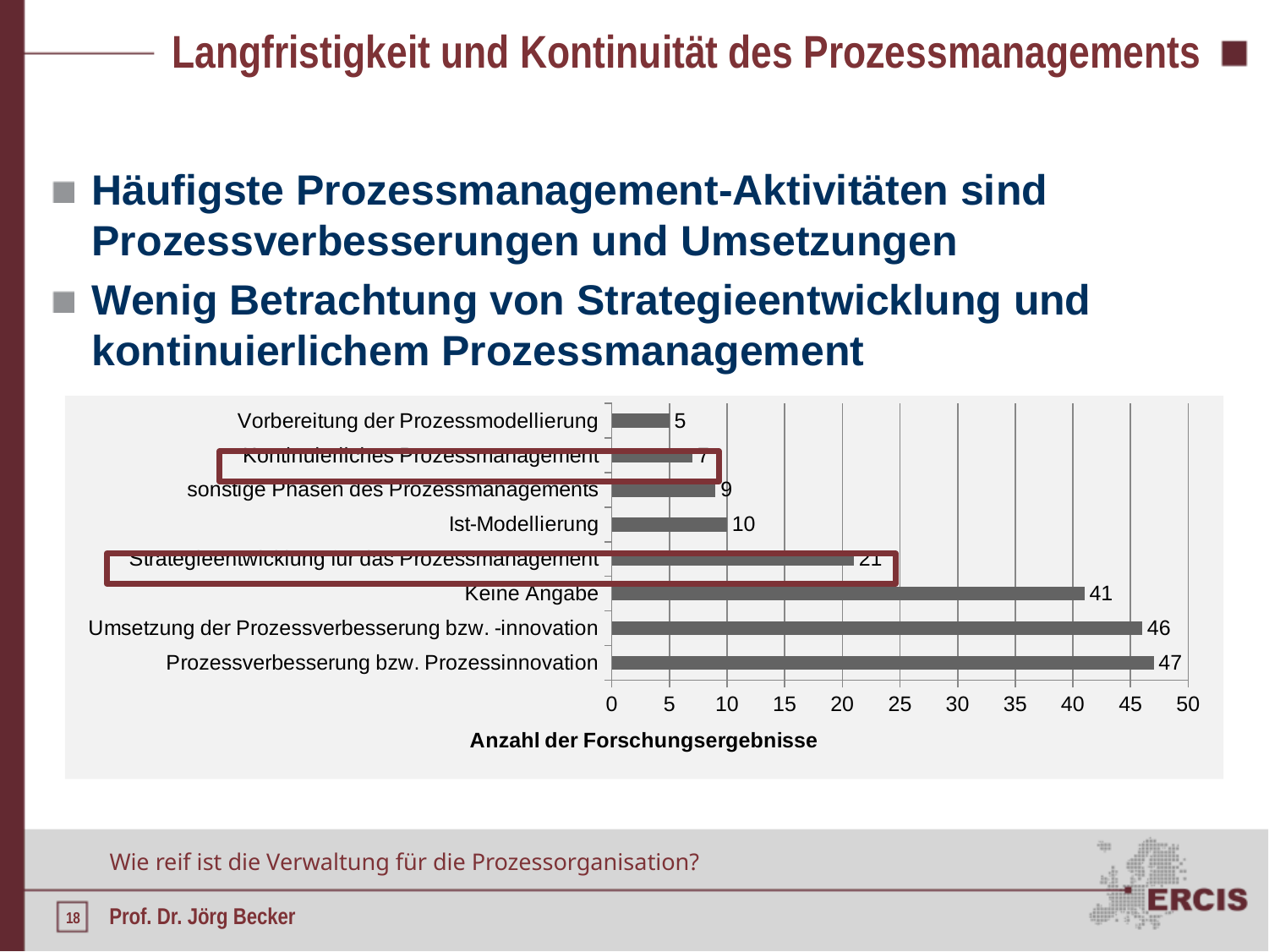
What is the difference between the values for Umsetzung der Prozessverbesserung bzw. -innovation and Kontinuierliches Prozessmanagement? 39 What kind of chart is shown on the slide? bar chart What is the value for Prozessverbesserung bzw. Prozessinnovation? 47 What is the value for Keine Angabe? 41 Which category has the lowest value? Vorbereitung der Prozessmodellierung How many categories are plotted in the chart? 8 Is the value for sonstige Phasen des Prozessmanagements greater or less than 10? less What is the title of the x axis of the chart? Anzahl der Forschungsergebnisse Which is larger, the value for Keine Angabe or the value for Strategieentwicklung für das Prozessmanagement? Keine Angabe Which category has the highest value? Prozessverbesserung bzw. Prozessinnovation What is the value for Strategieentwicklung für das Prozessmanagement? 21 What is the value for Ist-Modellierung? 10